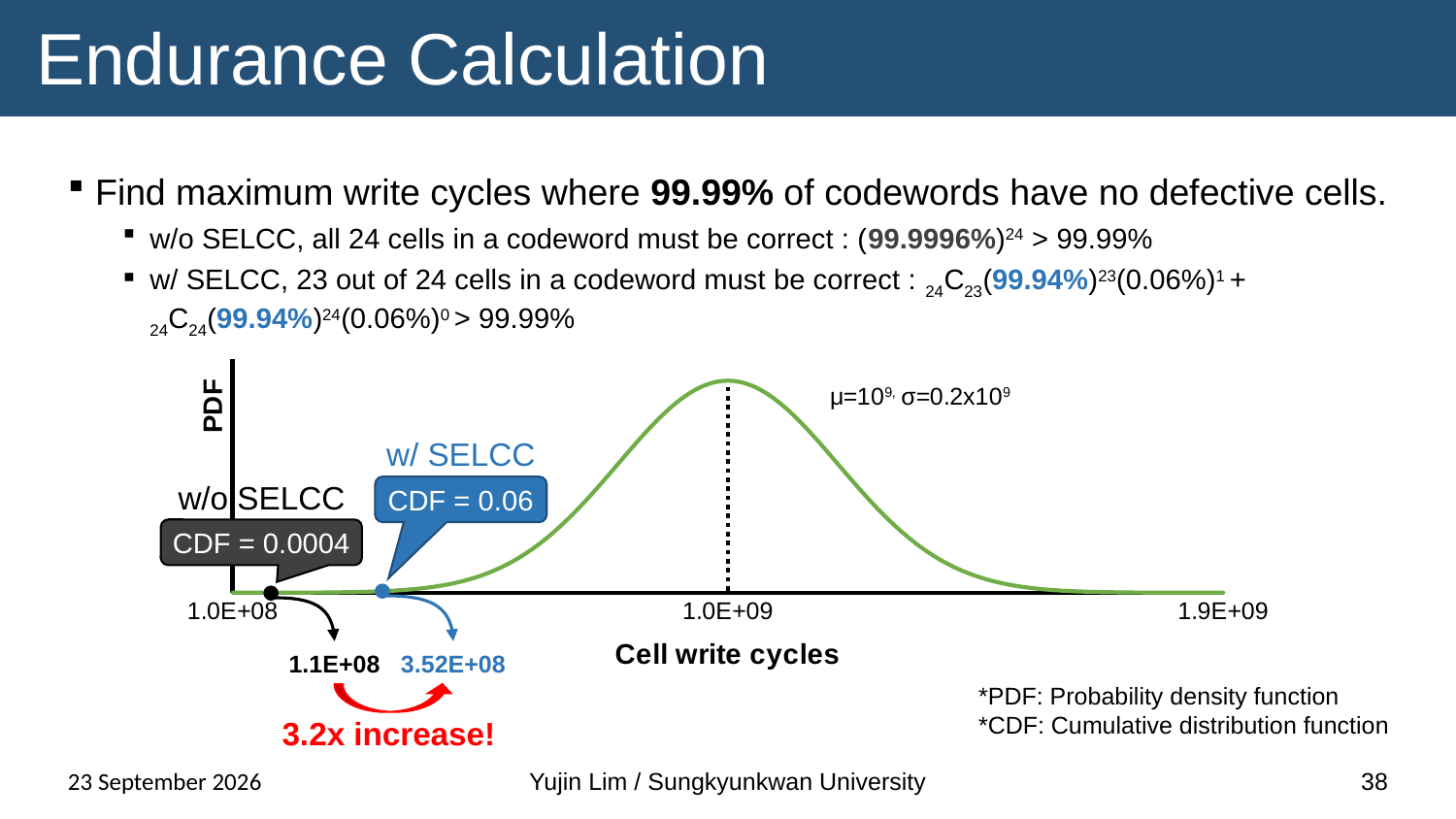
What is the largest tick value shown on the x axis? 1.9E+09 What cell write cycle value is marked for w/o SELCC? 1.1E+08 What is the CDF value shown for the w/ SELCC point on the chart? 0.06 What is the label of the x axis of the chart? Cell write cycles By what factor does the chart say the write cycles increase with SELCC? 3.2x At what cell write cycle value does the peak of the PDF curve occur? 1.0E+09 Is the w/ SELCC point's cell write cycle value greater or less than 1.0E+09? less What is the label of the y axis of the chart? PDF Which has the larger marked cell write cycle value, w/o SELCC or w/ SELCC? w/ SELCC What is the CDF value shown for the w/o SELCC point on the chart? 0.0004 What cell write cycle value is marked for w/ SELCC? 3.52E+08 What are the mean and standard deviation given for the distribution on the chart? μ=10^9, σ=0.2x10^9